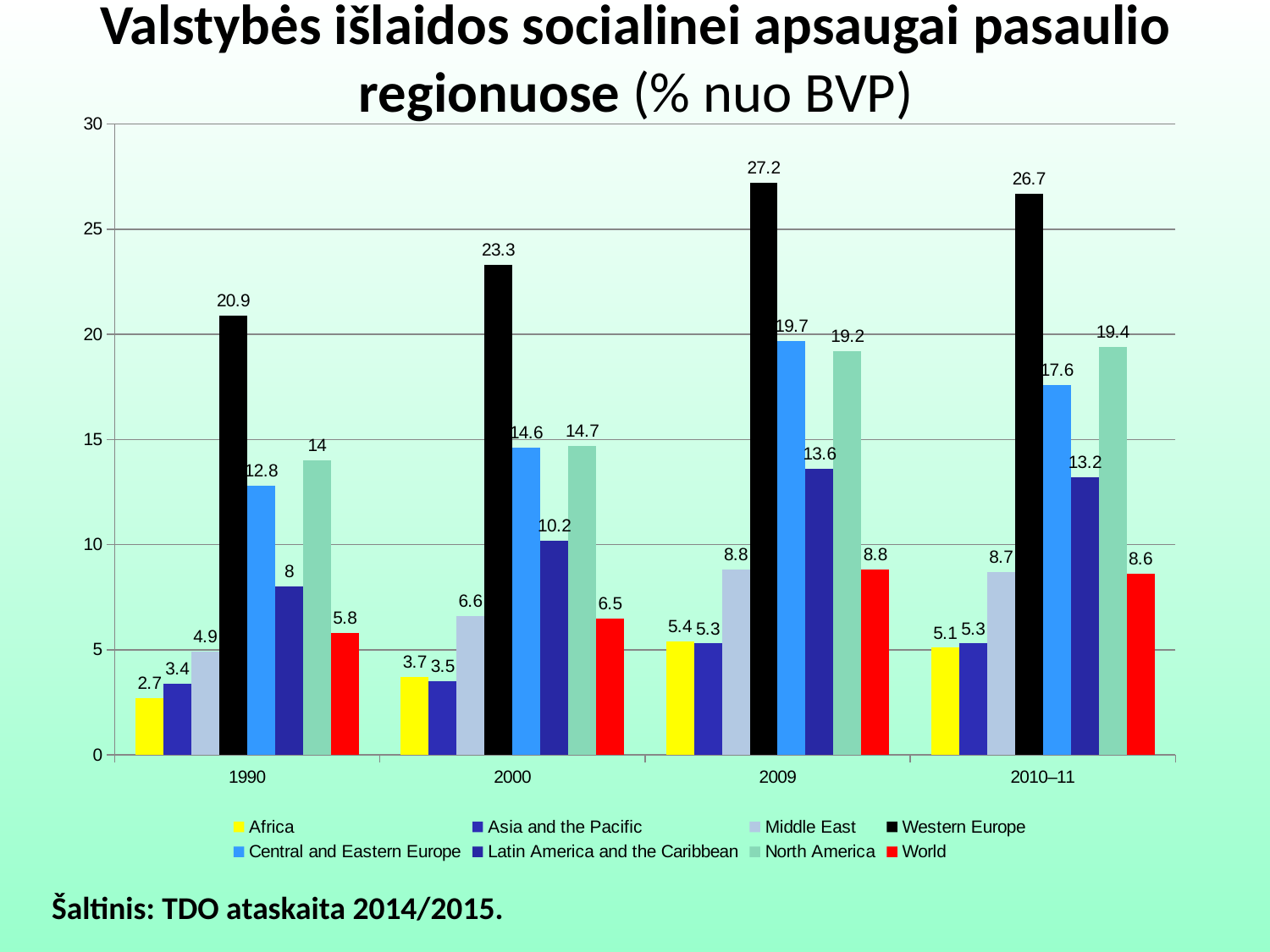
Which region has the highest value in 2000? Western Europe What is the difference between the Western Europe values for 2009 and 1990? 6.3 What is the value for World in 1990? 5.8 What is the value for North America in 2010–11? 19.4 What is the value for Western Europe in 2009? 27.2 What type of chart is shown on the slide? bar chart Does the value for Western Europe rise or fall from 1990 to 2009? rise How many year categories are shown on the x axis? 4 Which is larger in 2000: Central and Eastern Europe or North America? North America Which colour represents Western Europe in the legend? black How many series does the legend list? 8 Which region has the lowest value in 1990? Africa